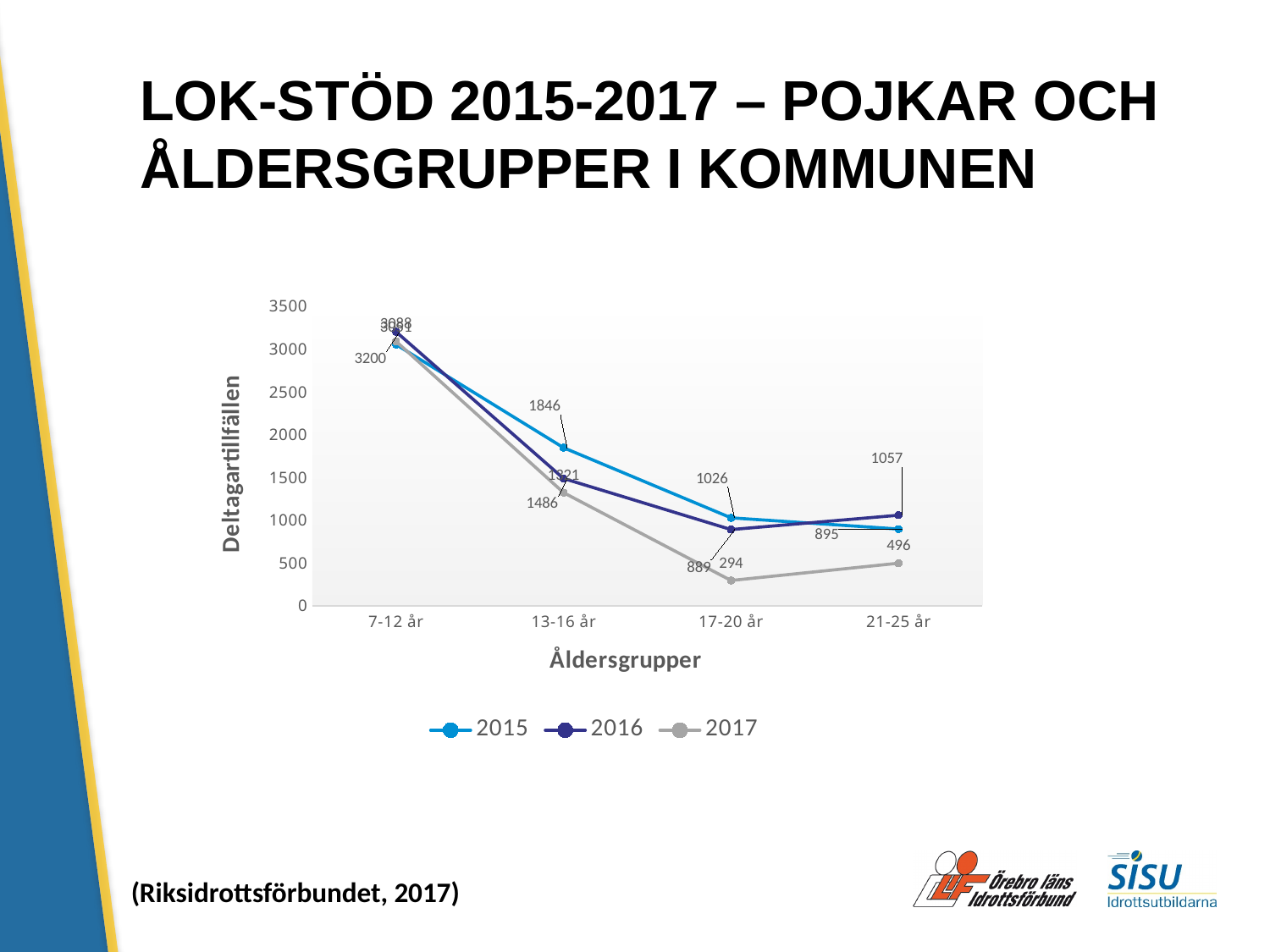
How many series does the legend list? 3 What is the value for 2017 in the 17-20 år age group? 294 What is the title of the y axis? Deltagartillfällen Is the value for 2015 in the 13-16 år age group greater or less than 1500? greater In the 17-20 år age group, which series has the larger value, 2015 or 2016? 2015 What is the value for 2015 in the 17-20 år age group? 1026 What kind of chart is shown on the slide? line chart How many age groups are shown on the x axis? 4 What is the value for 2015 in the 21-25 år age group? 895 What is the value for 2016 in the 21-25 år age group? 1057 What is the value for 2017 in the 21-25 år age group? 496 What is the difference between the 2016 and 2017 values in the 21-25 år age group? 561